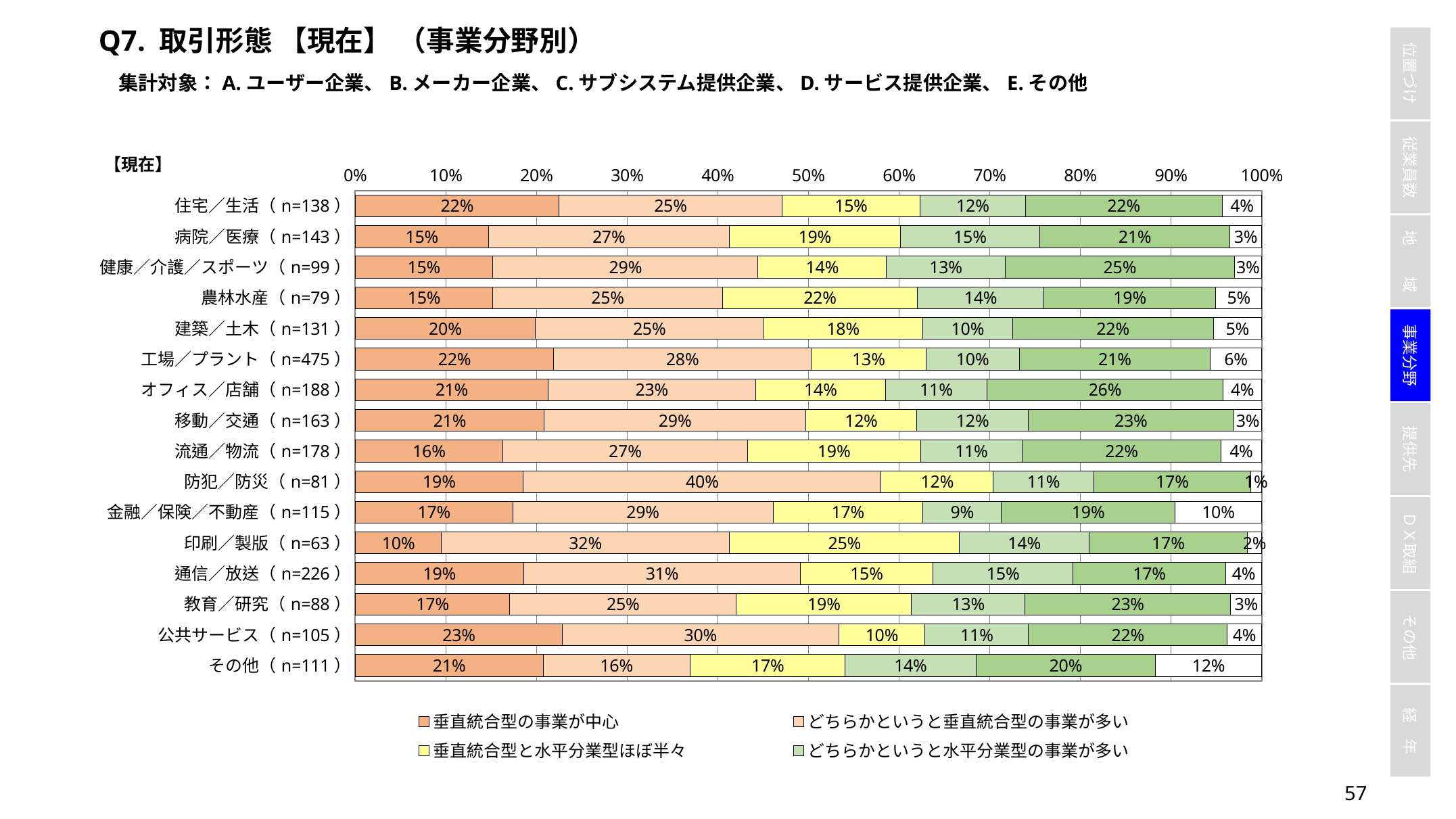
Which category has the highest value for 垂直統合型の事業が中心? 公共サービス Which has the larger value for 垂直統合型と水平分業型ほぼ半々, 農林水産 or 工場／プラント? 農林水産 What is the value of どちらかというと垂直統合型の事業が多い for 防犯／防災? 40% What is the value of どちらかというと水平分業型の事業が多い for 金融／保険／不動産? 9% What kind of chart is shown on the slide? Stacked bar chart Which category has the highest value for どちらかというと垂直統合型の事業が多い? 防犯／防災 How many series does the legend list? 4 What is the difference between the 垂直統合型の事業が中心 values for 公共サービス and 印刷／製版? 13 percentage points What is the value of 垂直統合型と水平分業型ほぼ半々 for 印刷／製版? 25% Which category has the lowest value for 垂直統合型の事業が中心? 印刷／製版 What is the value of 垂直統合型の事業が中心 for 住宅／生活? 22% How many business-field categories are plotted on the chart? 16